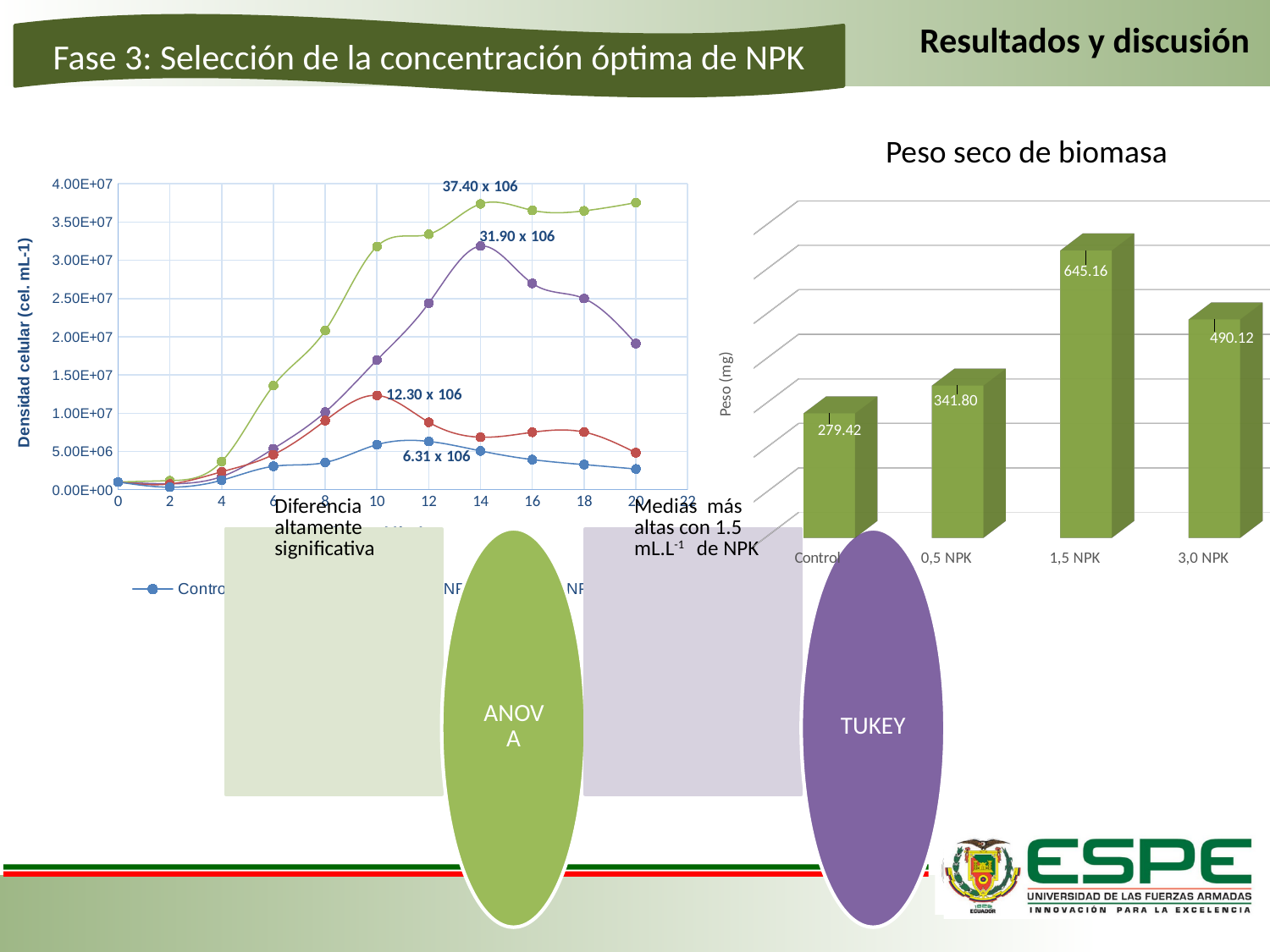
In the 'Peso seco de biomasa' chart, what is the value for 1,5 NPK? 645.16 In the 'Peso seco de biomasa' chart, what is the difference between the values for 1,5 NPK and 3,0 NPK? 155.04 What kind of chart is the 'Peso seco de biomasa' chart on the right? Bar chart In the 'Peso seco de biomasa' chart, what is the value for 3,0 NPK? 490.12 In the 'Peso seco de biomasa' chart, what is the difference between the values for 0,5 NPK and Control? 62.38 In the 'Peso seco de biomasa' chart, what is the value for Control? 279.42 In the 'Peso seco de biomasa' chart, which category has the highest value? 1,5 NPK In the 'Peso seco de biomasa' chart, which category has the lowest value? Control How many categories are shown in the 'Peso seco de biomasa' chart? 4 In the line chart on the left, what is the highest data label shown? 37.40 x 106 In the 'Peso seco de biomasa' chart, which is larger, the value for 3,0 NPK or the value for 0,5 NPK? 3,0 NPK What kind of chart is the chart on the left of the slide? Line chart